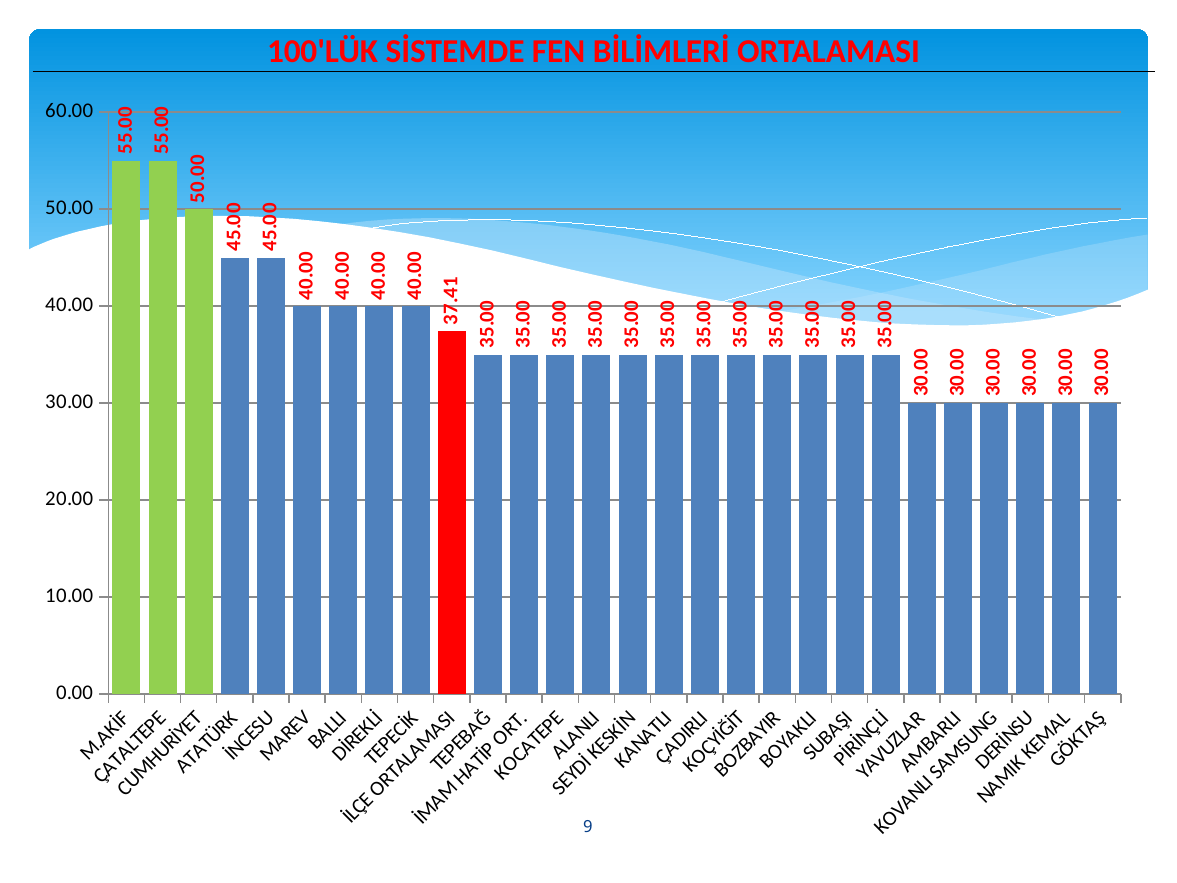
How many bars are shown on the chart? 28 What is the difference between the values for M.AKİF and GÖKTAŞ? 25.00 What is the value for ATATÜRK? 45.00 What is the difference between the values for CUMHURİYET and İLÇE ORTALAMASI? 12.59 Is the value for İNCESU greater or less than 40.00? greater What is the highest value shown on the chart? 55.00 Which has a larger value, MAREV or TEPEBAĞ? MAREV Do the values rise or fall from left to right along the x axis? fall What kind of chart is shown on the slide? bar chart What is the value for CUMHURİYET? 50.00 What is the value for GÖKTAŞ? 30.00 What is the value for İLÇE ORTALAMASI? 37.41